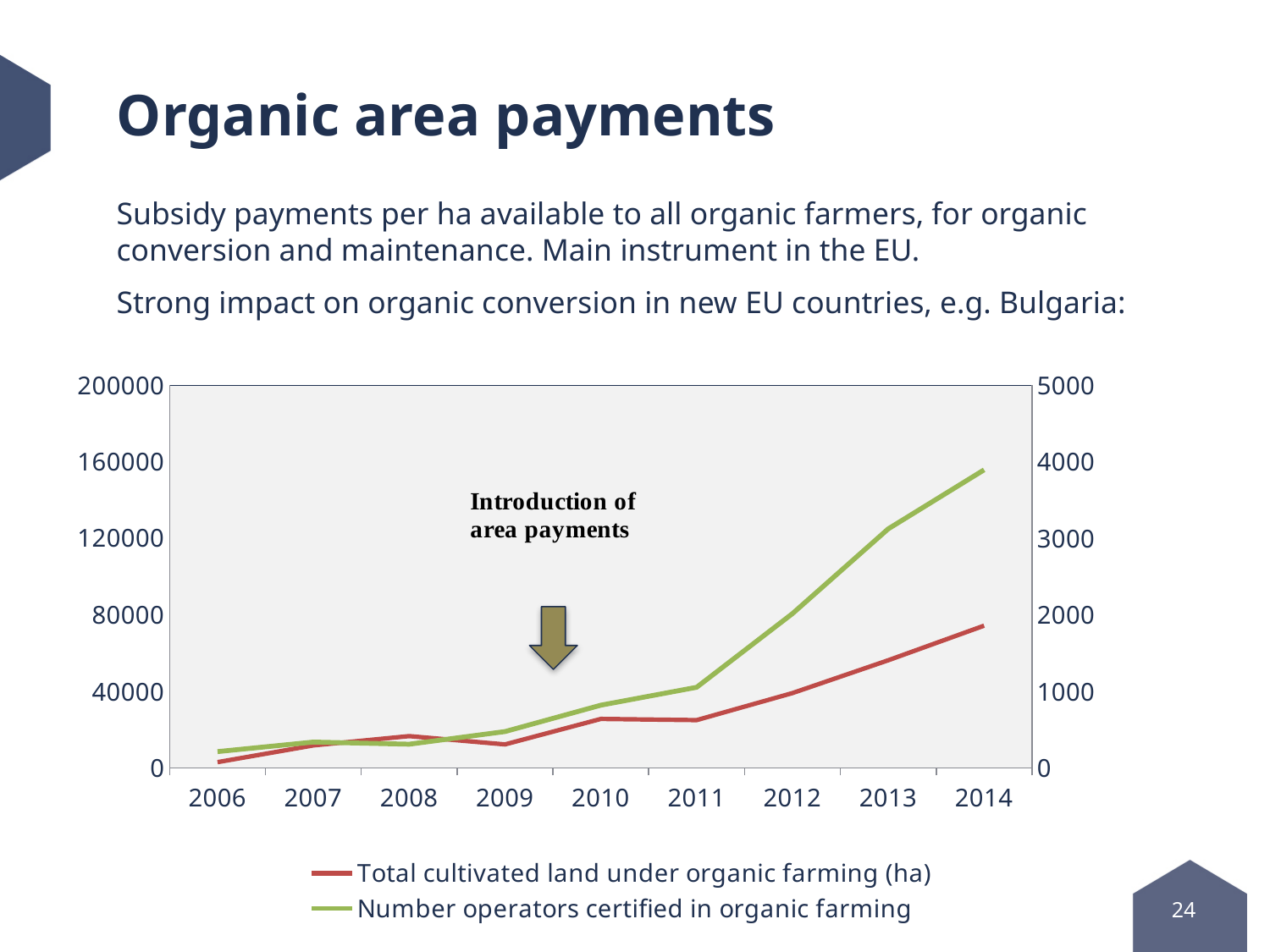
Is the value for Number operators certified in organic farming in 2010 greater or less than 1000 on the right axis? less What does the text annotation inside the chart say? Introduction of area payments Is the value for Total cultivated land under organic farming (ha) in 2014 greater or less than 80000? less Which year has the highest value for Number operators certified in organic farming? 2014 What kind of chart is shown on the slide? Line chart How many years are plotted along the x axis of the chart? 9 Is the value for Number operators certified in organic farming in 2014 greater or less than 3000 on the right axis? greater Overall, does the Number operators certified in organic farming rise or fall from 2006 to 2014? Rise Which year has the lowest value for Total cultivated land under organic farming (ha)? 2006 How many series does the chart legend list? 2 Which year has the highest value for Total cultivated land under organic farming (ha)? 2014